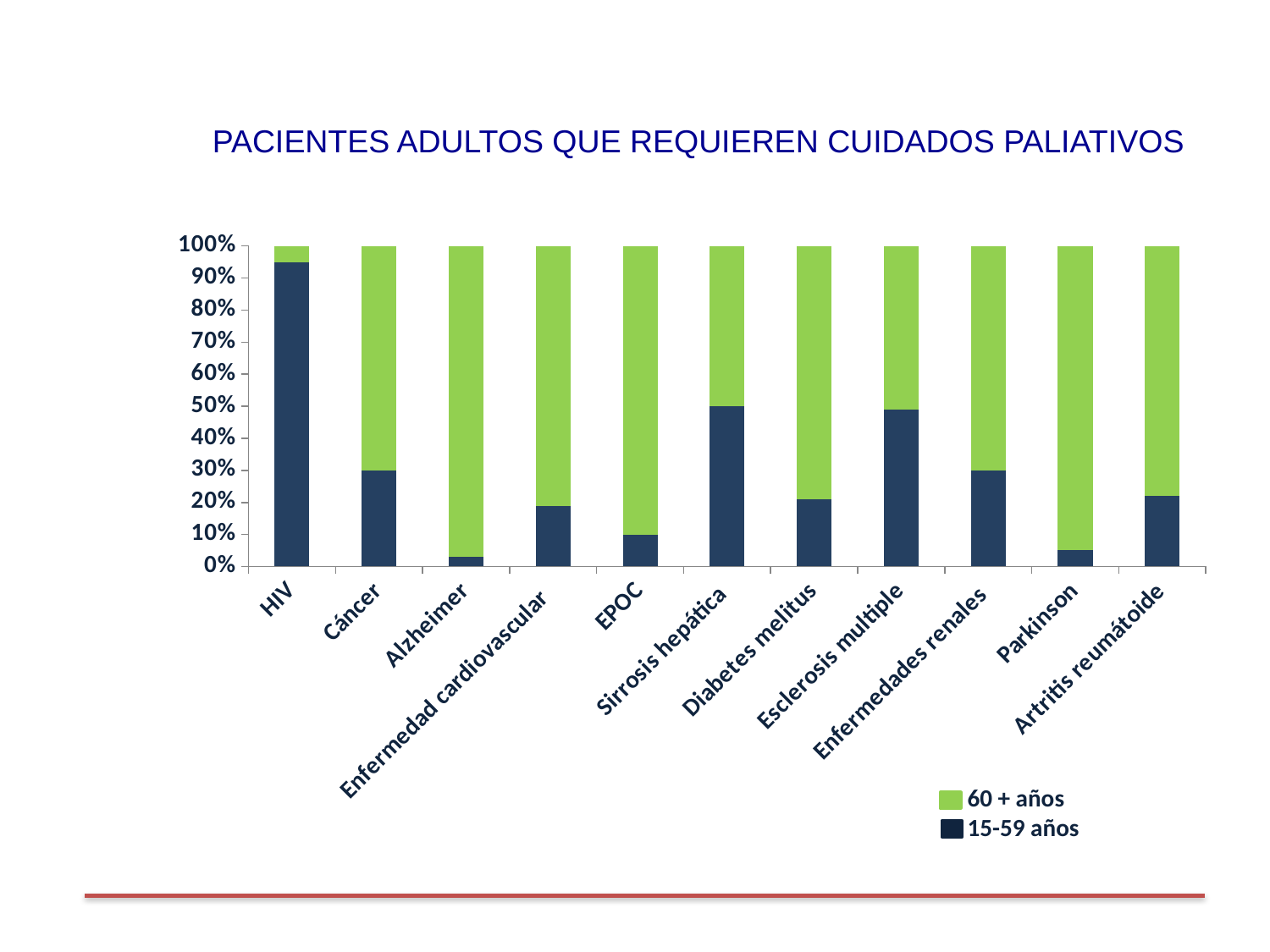
Which has a larger 60 + años share, Alzheimer or Sirrosis hepática? Alzheimer What is the title of the chart? PACIENTES ADULTOS QUE REQUIEREN CUIDADOS PALIATIVOS Which category has the highest share of 15-59 años patients? HIV Is the 15-59 años share for Enfermedad cardiovascular greater or less than 10%? greater What kind of chart is shown on the slide? Stacked bar chart How many series does the legend list? 2 Is the 15-59 años share for HIV greater or less than 90%? greater Is the 15-59 años share for Parkinson greater or less than 10%? less Which category has the lowest share of 15-59 años patients? Alzheimer Which has a larger 15-59 años share, Cáncer or EPOC? Cáncer How many disease categories are shown on the x axis? 11